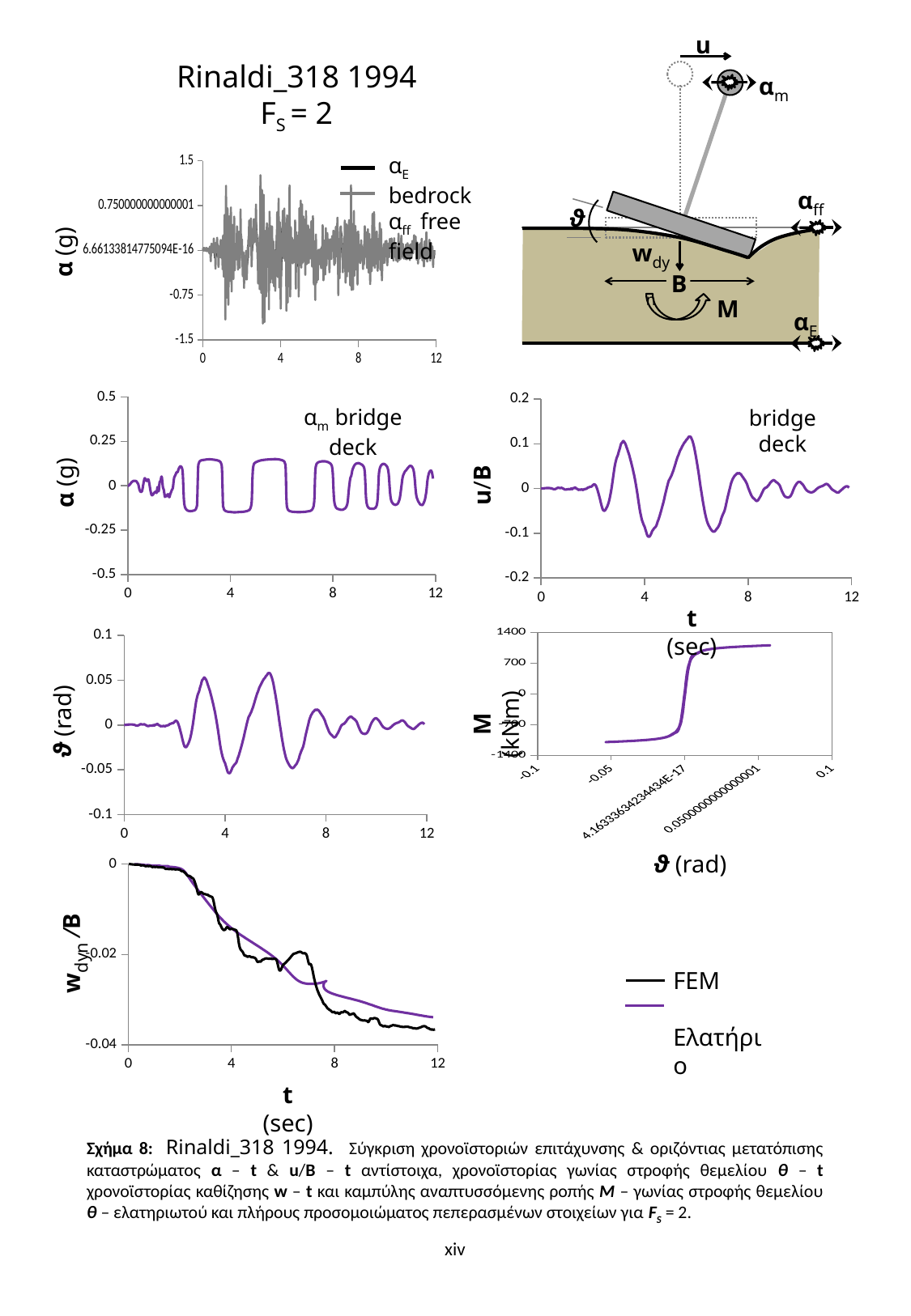
In the u/B bridge deck chart, is the maximum value of u/B greater or less than 0.2? less In the w_dyn/B versus t chart, is the FEM value at t = 12 greater or less than -0.02? less In the α_m bridge deck chart, is the maximum value of α greater or less than 0.25? less How many series does the legend of the top-left α (g) chart list? 2 In the w_dyn/B versus t chart, does the value of w_dyn/B rise or fall as t increases? fall What are the two legend entries of the w_dyn/B versus t chart? FEM and Ελατήριο What is the x-axis label of the w_dyn/B chart at the bottom left of the slide? t (sec) What kind of chart is the w_dyn/B versus t chart at the bottom left of the slide? line chart In the w_dyn/B versus t chart, which series has the lower value at t = 12: FEM or Ελατήριο? FEM How many series does the legend of the w_dyn/B versus t chart list? 2